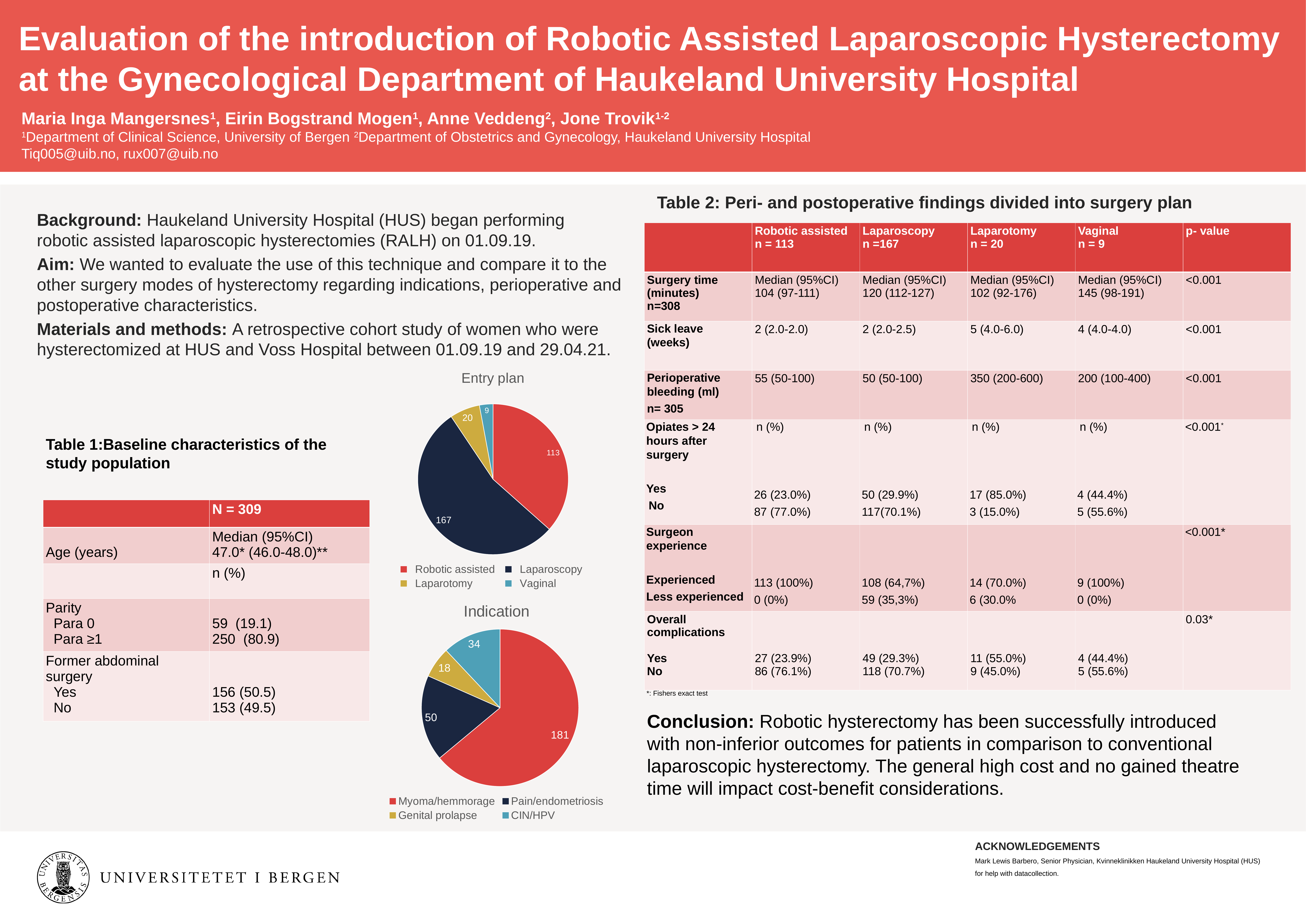
In the Indication chart, what is the difference between Myoma/hemmorage and Pain/endometriosis? 131 In the Entry plan chart, how many categories are shown? 4 In the Entry plan chart, which category has the largest slice? Laparoscopy In the Indication chart, which category has the largest slice? Myoma/hemmorage In the Entry plan chart, which category has the smallest slice? Vaginal In the Entry plan chart, what is the difference between Laparoscopy and Robotic assisted? 54 In the Indication chart, what is the value for Pain/endometriosis? 50 In the Indication chart, what is the value for CIN/HPV? 34 What type of chart is the Indication chart? Pie chart In the Entry plan chart, what is the value for Vaginal? 9 In the Indication chart, which is larger, Genital prolapse or CIN/HPV? CIN/HPV In the Entry plan chart, what is the value for Laparoscopy? 167